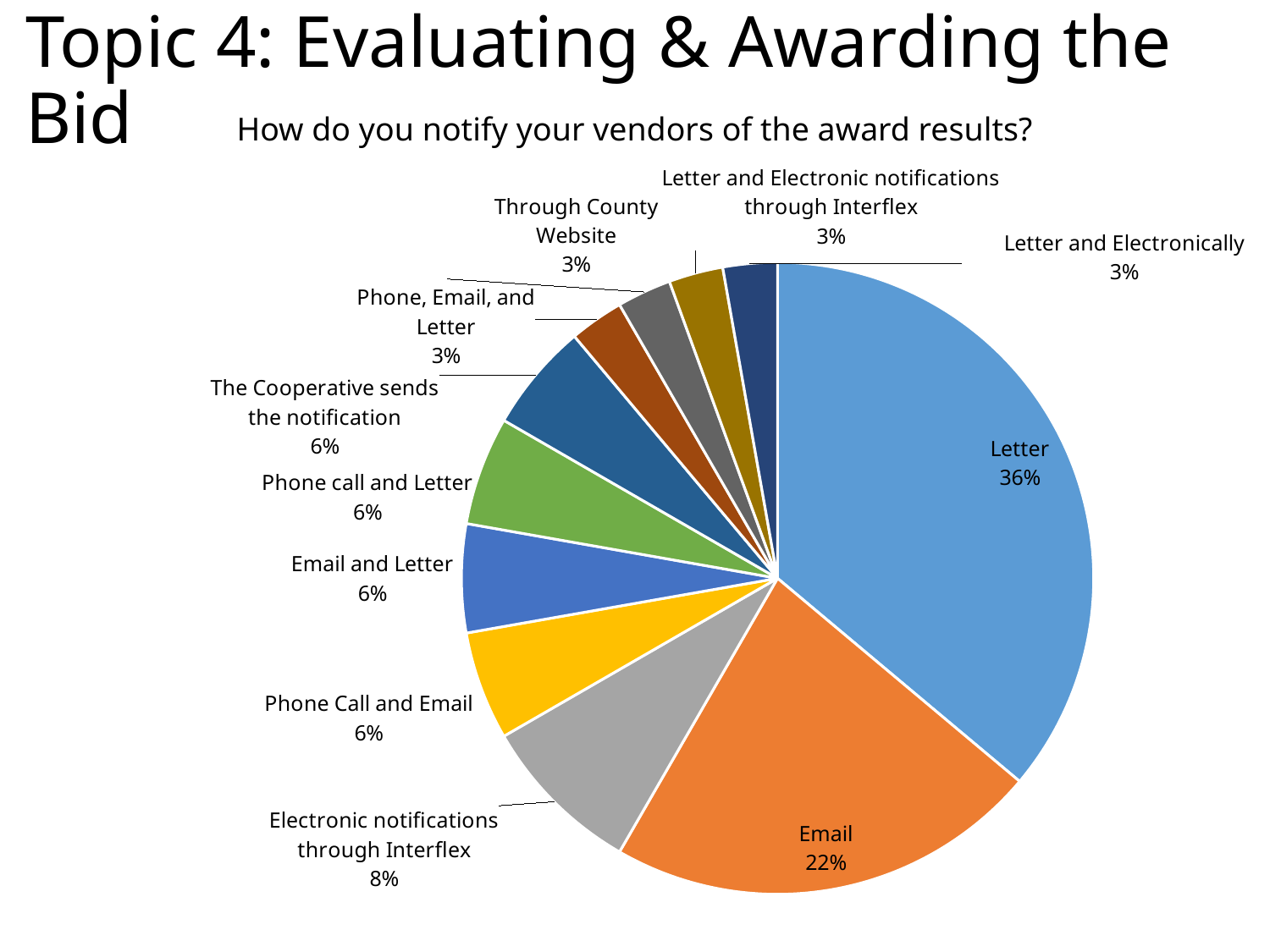
What share of the pie is 'Electronic notifications through Interflex'? 8% Which has a larger share: 'The Cooperative sends the notification' or 'Phone, Email, and Letter'? The Cooperative sends the notification What percentage of respondents notify vendors by Letter? 36% What type of chart is shown on the slide? Pie chart What percentage of respondents notify vendors by Email? 22% Which notification method has the largest share of the pie? Letter How many slices does the pie chart have? 11 What is the title of the chart? How do you notify your vendors of the award results? Which has a larger share: 'Electronic notifications through Interflex' or 'Email and Letter'? Electronic notifications through Interflex What percentage is shown for 'Phone Call and Email'? 6% What is the difference in percentage points between Letter and Email? 14 What percentage is shown for 'Through County Website'? 3%